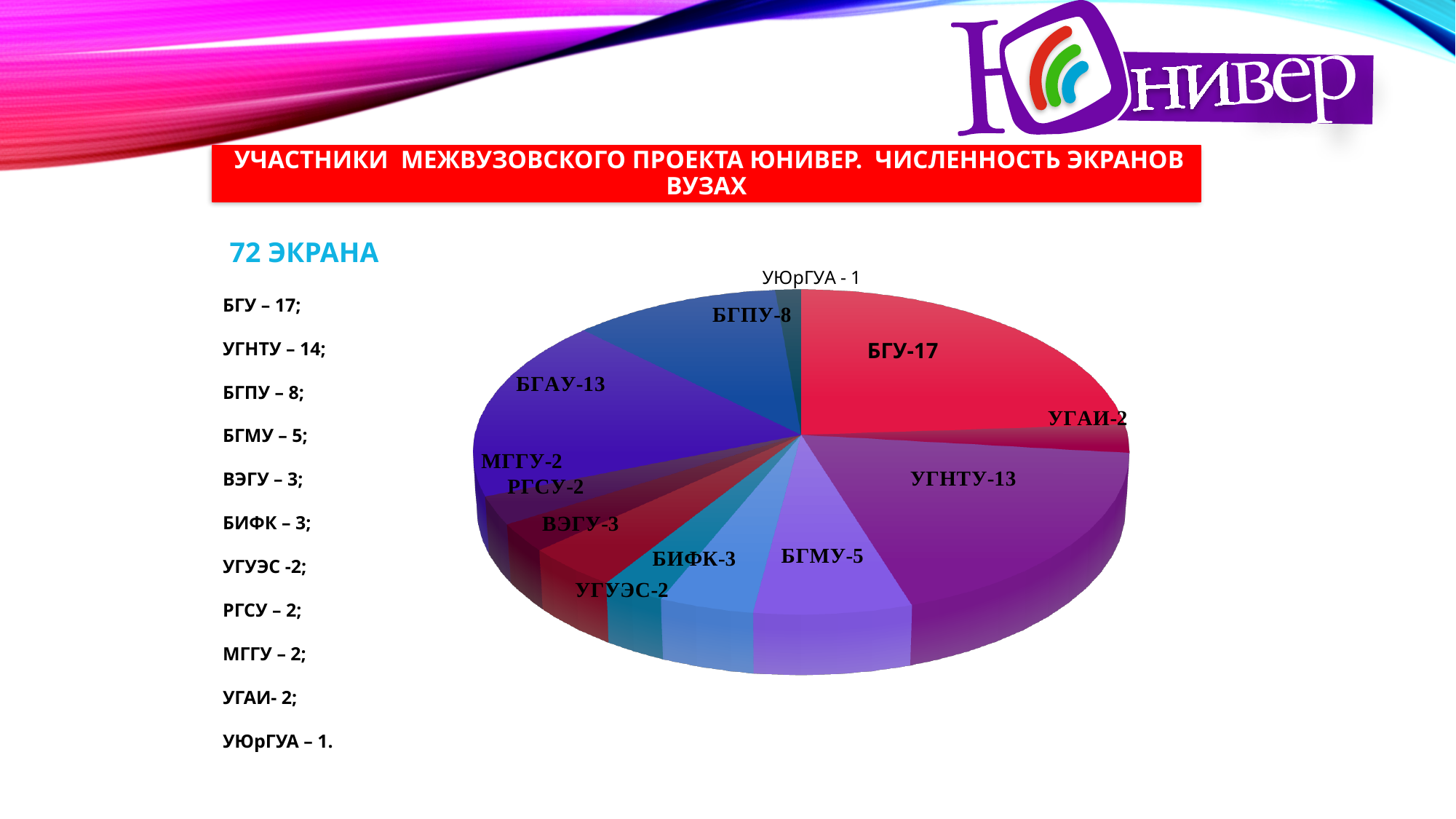
What number of screens is stated in the blue heading above the list on the left of the slide? 72 ЭКРАНА What value is shown for БГПУ in the pie chart? 8 What value is shown for БГУ in the pie chart? 17 Which has a larger value in the pie chart, БГМУ or БИФК? БГМУ What is the difference between the values for УГНТУ and БГМУ in the pie chart? 8 How many slices does the pie chart have? 12 Which university has the smallest slice in the pie chart? УЮрГУА Which university has the largest slice in the pie chart? БГУ What is the difference between the values for БГУ and БГПУ in the pie chart? 9 What kind of chart is shown on the slide? pie chart What value is shown for БГМУ in the pie chart? 5 What value is shown for БГАУ in the pie chart? 13